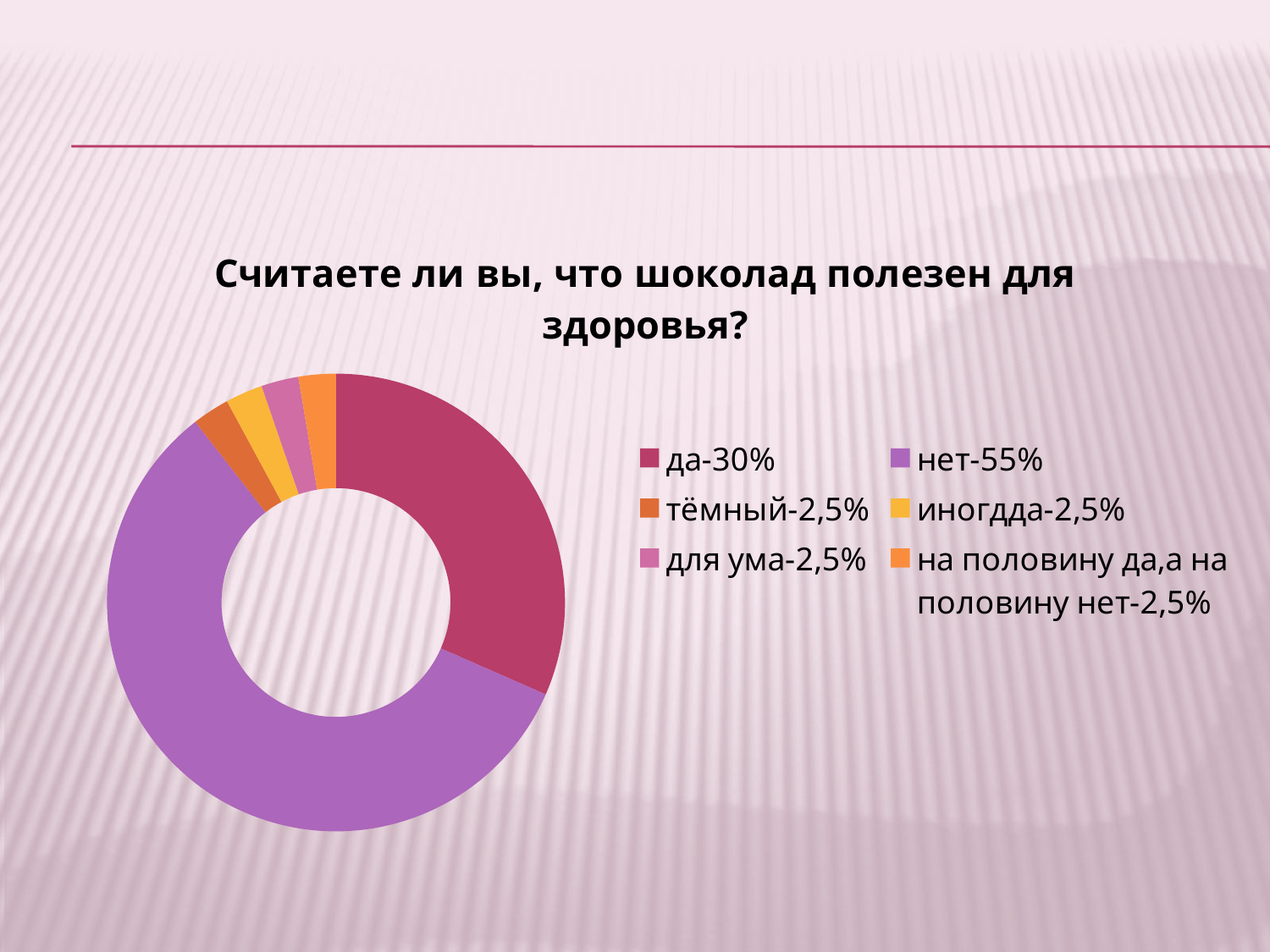
What percentage is shown for the category "для ума"? 2,5% What percentage is shown for the category "да"? 30% Which is larger, the share for "да" or the share for "нет"? нет What percentage is shown for the category "тёмный"? 2,5% How many categories does the chart have? 6 What percentage is shown for the category "на половину да,а на половину нет"? 2,5% What colour is the slice for "нет"? purple What percentage is shown for the category "нет"? 55% Which category has the largest share of the chart? нет What is the difference between the share for "нет" and the share for "да"? 25% What is the title of the chart? Считаете ли вы, что шоколад полезен для здоровья? What kind of chart is shown on the slide? doughnut (pie) chart